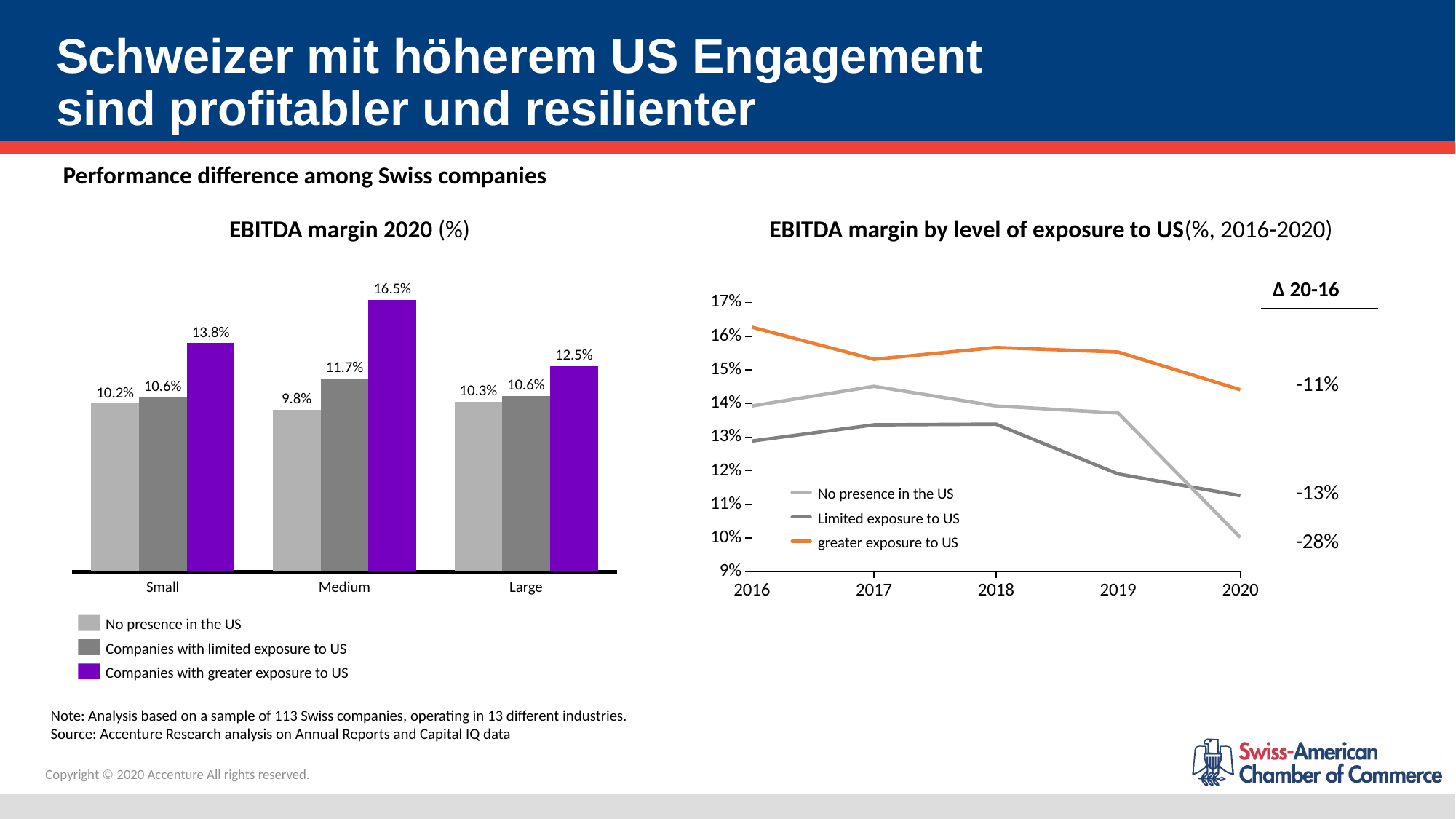
In the EBITDA margin by level of exposure to US chart, how many series does the legend list? 3 In the EBITDA margin 2020 chart, which size category has the lowest value for companies with no presence in the US? Medium In the EBITDA margin 2020 chart, what is the difference between the greater exposure and no presence values for Medium companies? 6.7% How many size categories are shown in the EBITDA margin 2020 chart? 3 In the EBITDA margin 2020 chart, which size category has the highest value for companies with greater exposure to the US? Medium In the EBITDA margin 2020 chart, what is the EBITDA margin for Medium companies with greater exposure to the US? 16.5% In the EBITDA margin by level of exposure to US chart, is the 2016 value for greater exposure to US greater or less than 16%? greater In the EBITDA margin 2020 chart, what is the value for Large companies with limited exposure to the US? 10.6% In the EBITDA margin 2020 chart, what is the EBITDA margin for Small companies with no presence in the US? 10.2% In the EBITDA margin by level of exposure to US chart, what is the Δ 20-16 value shown for No presence in the US? -28% What type of chart is the EBITDA margin 2020 chart? Bar chart In the EBITDA margin 2020 chart, which is larger for Large companies: greater exposure to US or limited exposure to US? Greater exposure to US